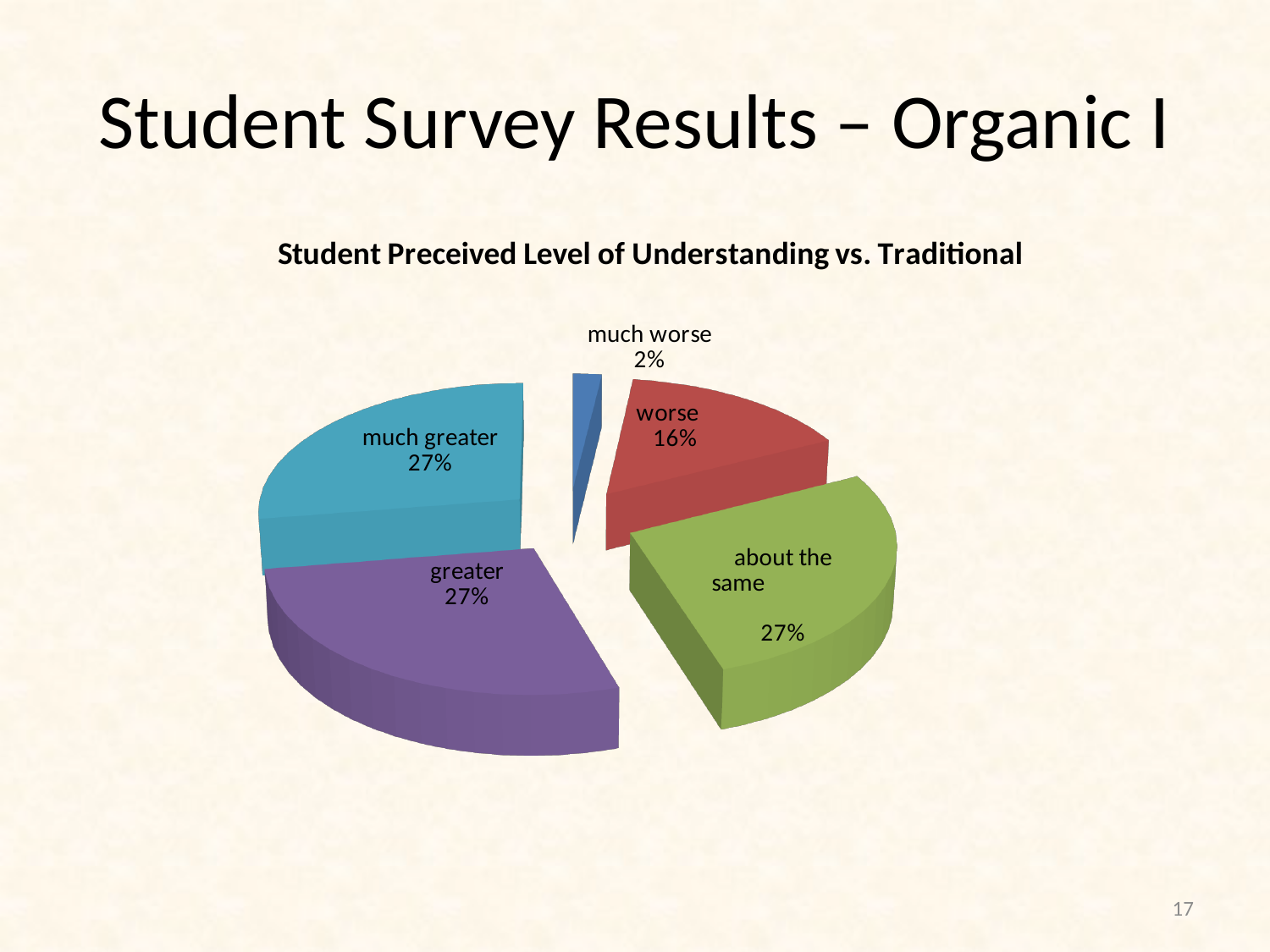
What is the title of the chart? Student Preceived Level of Understanding vs. Traditional Which is larger, the "worse" slice or the "much worse" slice? worse What is the difference in percentage points between the "about the same" slice and the "worse" slice? 11 Which is larger, the "greater" slice or the "worse" slice? greater What percentage is shown for the "much greater" slice? 27% What share of the pie is labelled "about the same"? 27% What share of the pie is labelled "much worse"? 2% What share of the pie is labelled "worse"? 16% What kind of chart is shown on the slide? pie chart How many slices does the pie chart have? 5 What is the difference in percentage points between the "worse" slice and the "much worse" slice? 14 Which category has the smallest slice of the pie? much worse